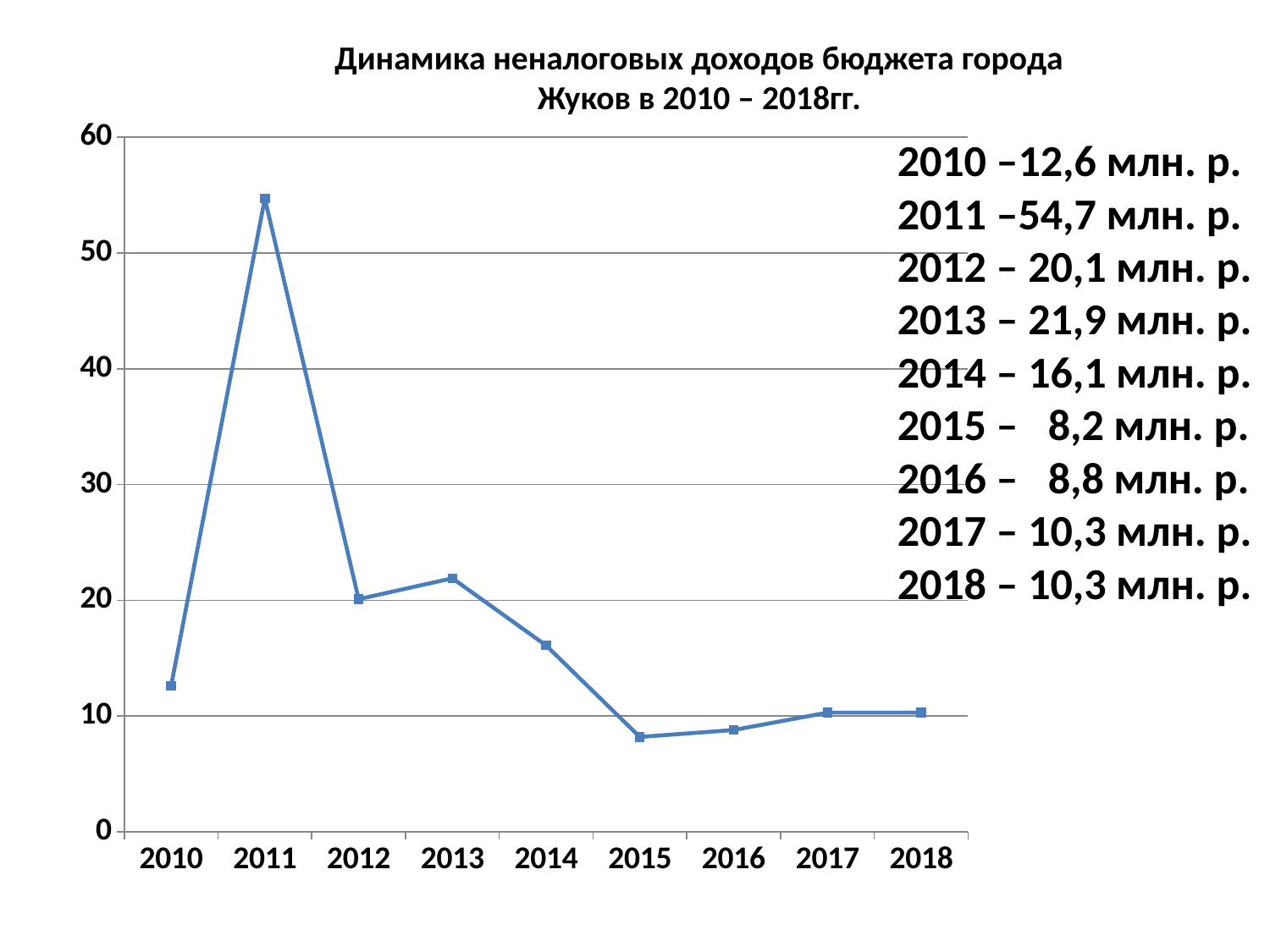
What kind of chart is shown on the slide? line chart Which year has the lowest value on the chart? 2015 How many years are plotted on the x axis of the chart? 9 What is the value for 2014 according to the slide? 16,1 млн. р. Which year has the highest value on the chart? 2011 Is the value for 2011 greater or less than 50? greater Which is larger, the value for 2013 or the value for 2012? 2013 What is the value for 2011 according to the slide? 54,7 млн. р. Do the values rise or fall from 2013 to 2015? fall What is the title of the chart? Динамика неналоговых доходов бюджета города Жуков в 2010 – 2018гг. What is the value for 2010 according to the slide? 12,6 млн. р. What is the difference between the values for 2011 and 2012? 34,6 млн. р.